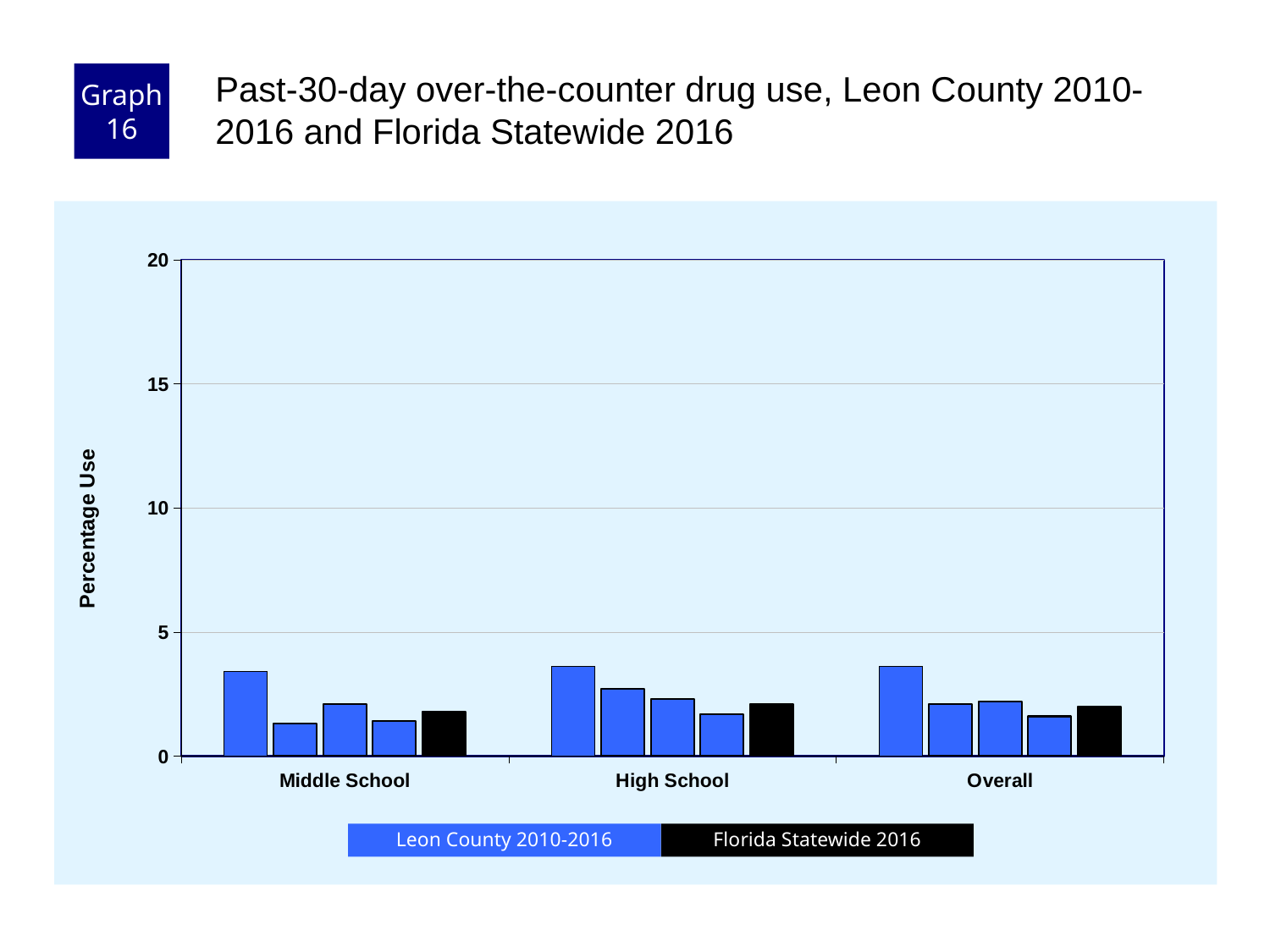
What is the highest value shown on the y axis of the chart? 20 What kind of chart is shown on the slide? bar chart What is the label on the y axis of the chart? Percentage Use Are any of the bars in the chart greater than 5? No Which colour represents Florida Statewide 2016 in the chart? black How many categories are shown on the x axis of the chart? 3 Is the value for Florida Statewide 2016 in the Overall category greater or less than 10? less In the Middle School category, is the Florida Statewide 2016 bar taller or shorter than the tallest Leon County 2010-2016 bar? shorter How many series does the chart legend list? 2 Is the value for Florida Statewide 2016 in the Middle School category greater or less than 5? less